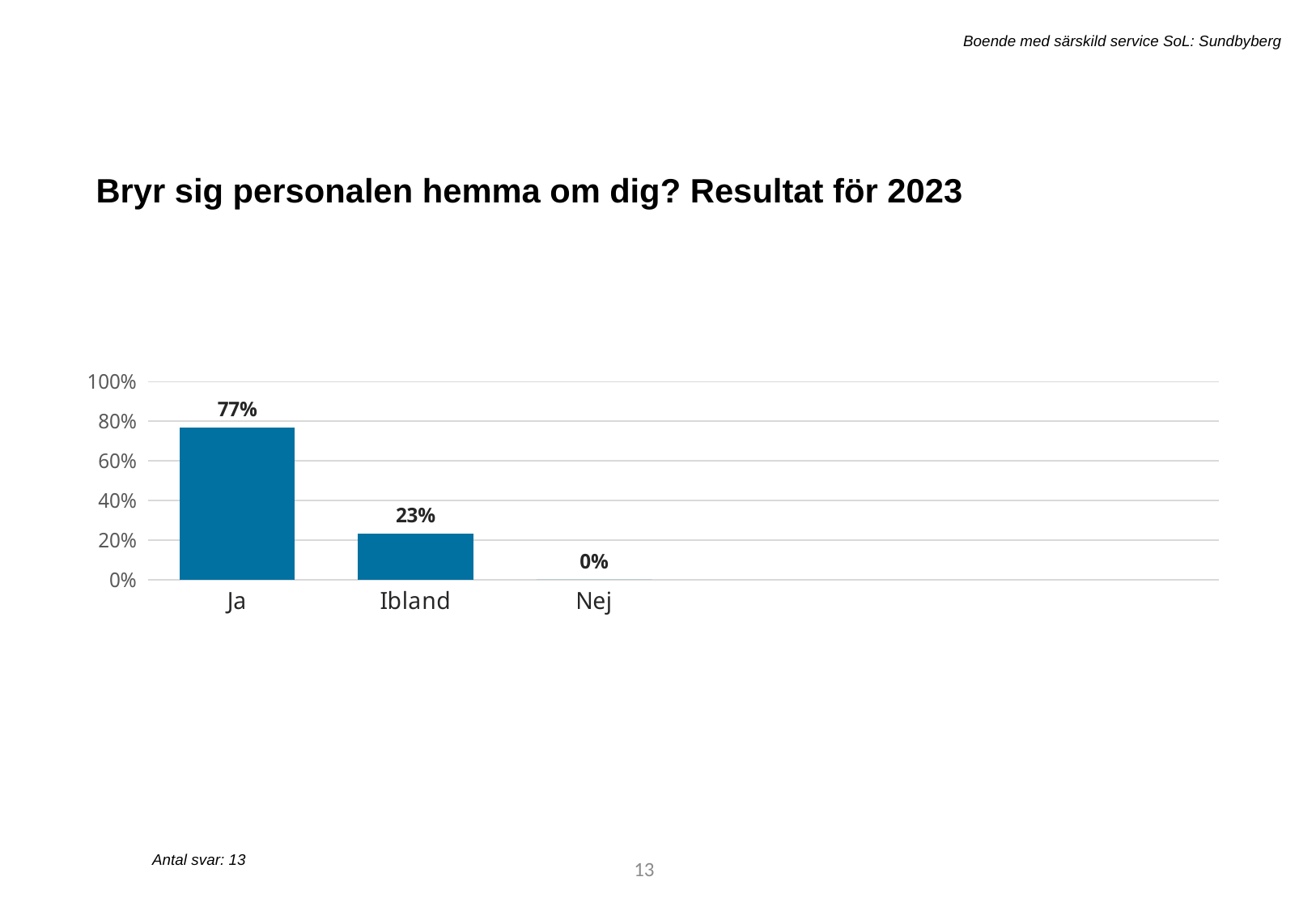
What is the value for Nej? 0% What is the value for Ja? 77% Do the values rise or fall from left to right along the x axis? fall What is the value for Ibland? 23% What is the difference between the values for Ja and Ibland? 54% Which category has the highest value? Ja What is the title of the chart? Bryr sig personalen hemma om dig? Resultat för 2023 How many categories are shown on the x axis? 3 Which is larger, the value for Ibland or the value for Nej? Ibland Is the value for Ja greater or less than 60%? greater What kind of chart is shown on the slide? bar chart Which category has the lowest value? Nej